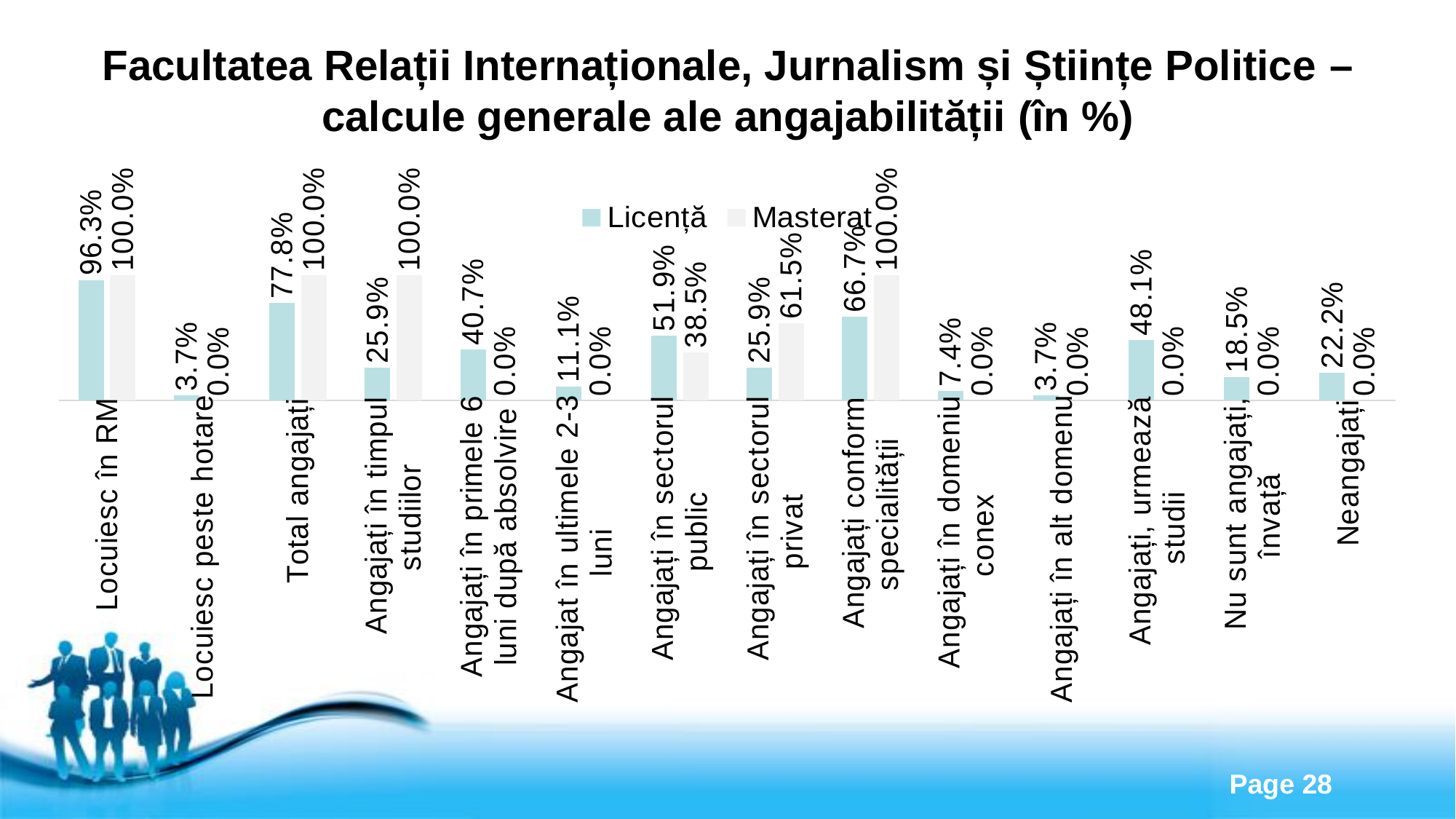
What is the Licență value for Angajați în primele 6 luni după absolvire? 40.7% What is the Licență value for Total angajați? 77.8% Which series is shown in light blue in the legend? Licență What is the difference between the Licență values for Angajați, urmează studii and Neangajați? 25.9% How many series does the legend list? 2 How many categories are shown on the x axis? 14 What is the difference between the Licență and Masterat values for Angajați în sectorul privat? 35.6% What is the Masterat value for Angajați în sectorul privat? 61.5% What kind of chart is shown on the slide? Bar chart Which category has the highest Licență value? Locuiesc în RM What is the Masterat value for Angajați în sectorul public? 38.5% Which is larger for Angajați în sectorul public: the Licență value or the Masterat value? Licență